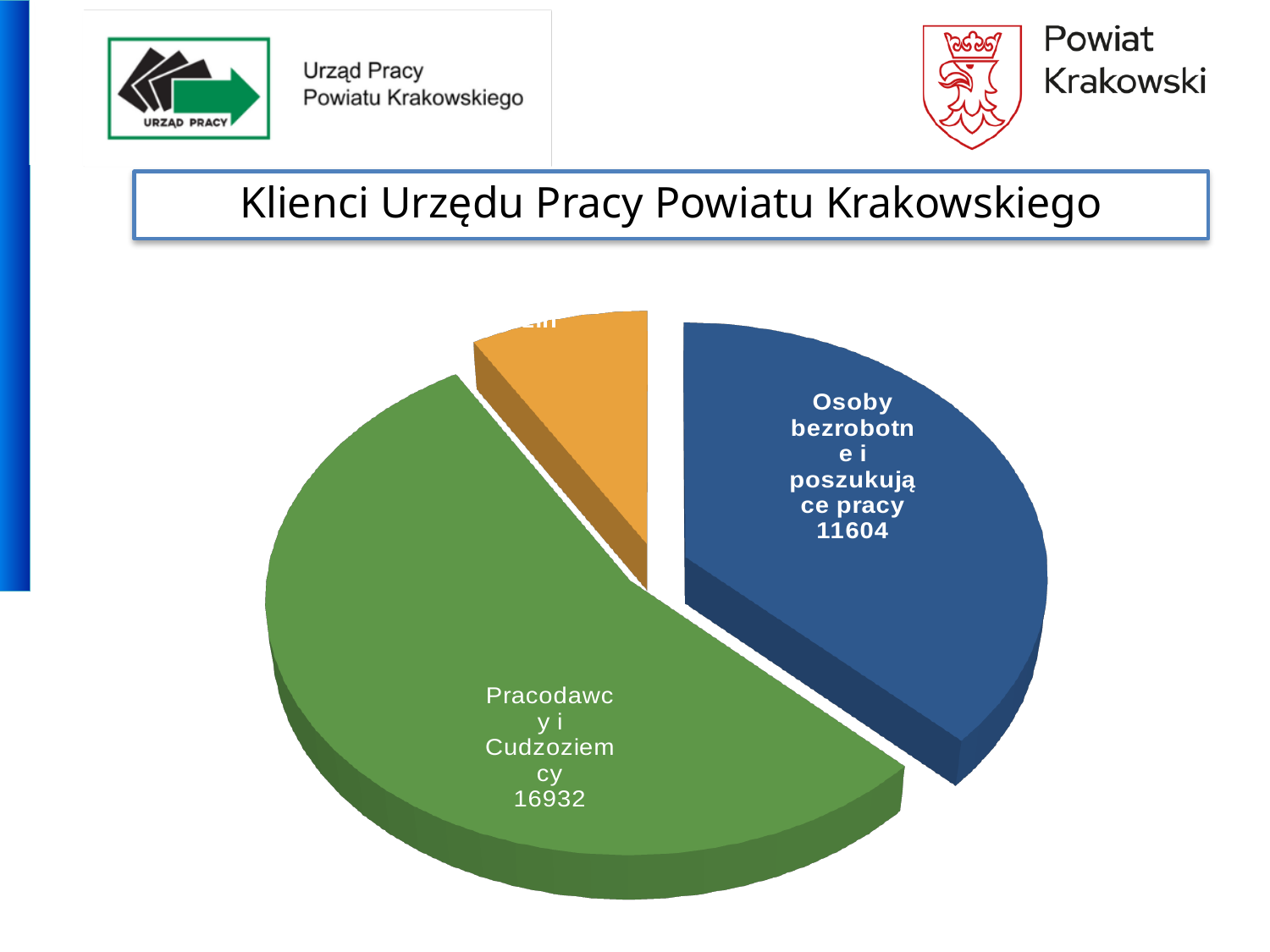
What is the value for Pracodawcy i Cudzoziemcy? 16932 What is the difference between the value for Pracodawcy i Cudzoziemcy and the value for Osoby bezrobotne i poszukujące pracy? 5328 What is the title of the chart? Klienci Urzędu Pracy Powiatu Krakowskiego Which category has the largest slice of the pie? Pracodawcy i Cudzoziemcy How many slices does the pie chart have? 3 What colour is the slice for Osoby bezrobotne i poszukujące pracy? blue What kind of chart is shown on the slide? pie chart What is the value for Osoby bezrobotne i poszukujące pracy? 11604 Which slice is larger: Pracodawcy i Cudzoziemcy or Osoby bezrobotne i poszukujące pracy? Pracodawcy i Cudzoziemcy